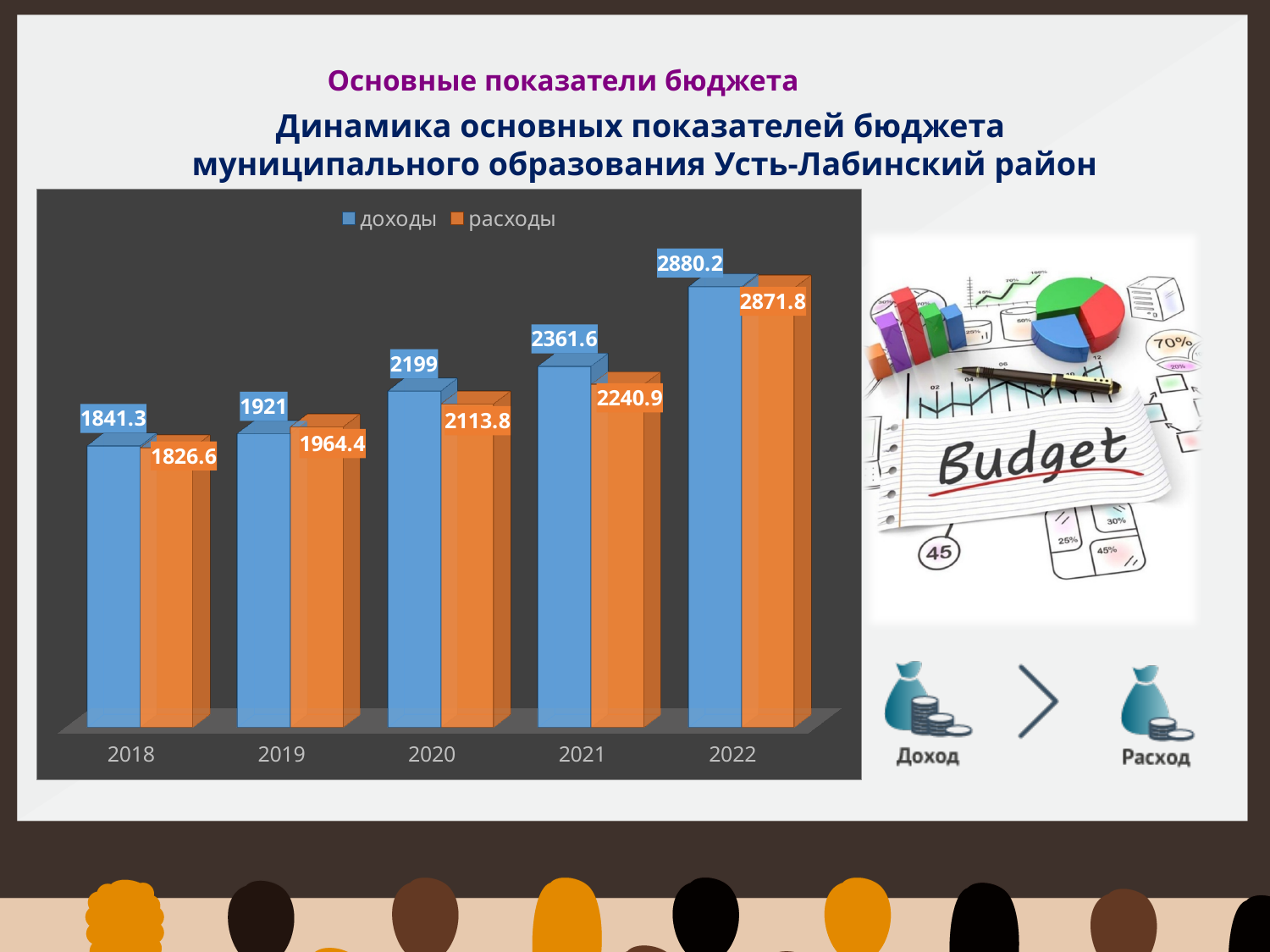
What is the difference between доходы and расходы in 2021? 120.7 What is the value of расходы for 2021? 2240.9 What is the value of доходы for 2018? 1841.3 What kind of chart is shown on the slide? bar chart Which year has the lowest value of доходы? 2018 What is the value of доходы for 2020? 2199 How many years are shown on the x axis? 5 How many series does the legend list? 2 Which year has the highest value of расходы? 2022 Do the values of доходы rise or fall from 2018 to 2022? rise In 2019, which is larger: доходы or расходы? расходы What is the difference between доходы and расходы in 2022? 8.4